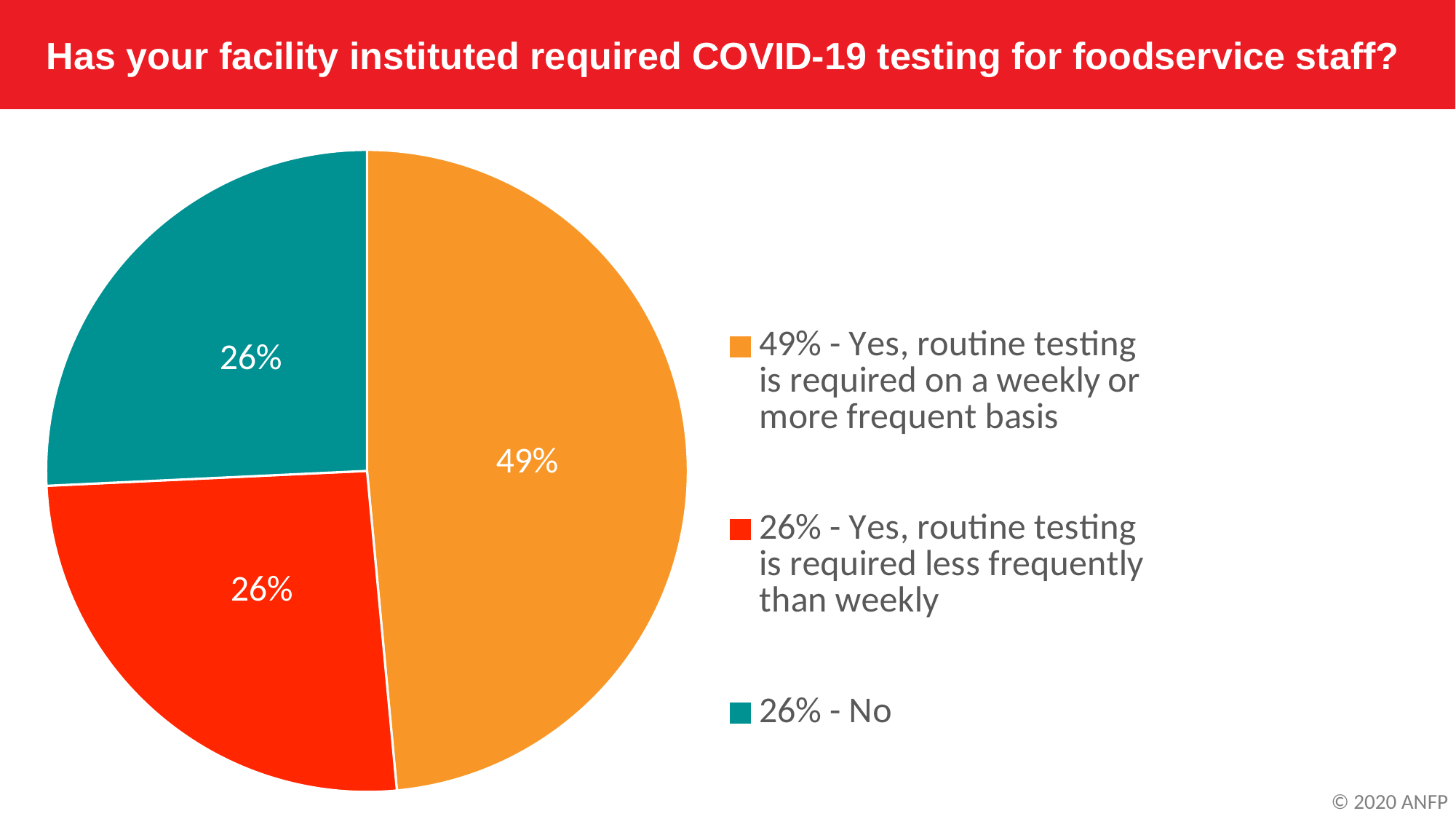
What is the difference in percentage points between the weekly-or-more-frequent testing slice and the No slice? 23 What share of respondents said routine testing is required less frequently than weekly? 26% How many slices does the pie chart have? 3 What is the combined share of the two 'Yes' responses? 75% What question does the chart title ask? Has your facility instituted required COVID-19 testing for foodservice staff? What colour is the slice representing the No response? teal Which is larger: the share for weekly or more frequent testing, or the share for testing less frequently than weekly? weekly or more frequent testing What share of respondents answered No? 26% What kind of chart is shown on the slide? pie chart How many entries does the legend list? 3 What share of respondents said routine testing is required on a weekly or more frequent basis? 49% Which response has the largest slice of the pie? Yes, routine testing is required on a weekly or more frequent basis